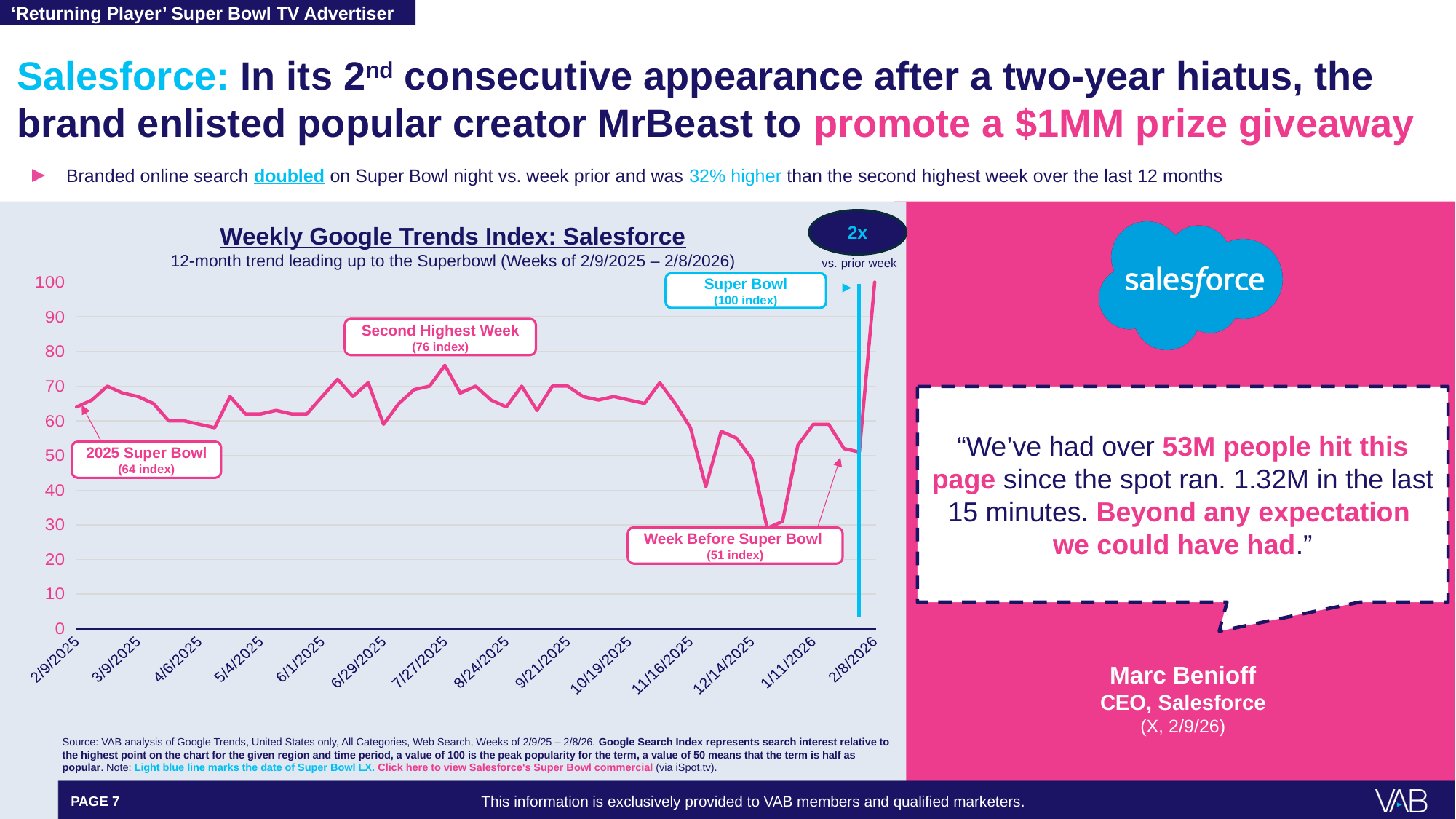
Is the lowest dip in the line, near 12/14/2025, greater or less than 40? less Which has a higher index: the 2025 Super Bowl week or the Week Before Super Bowl? 2025 Super Bowl week According to the callout above the chart, how much higher was the Super Bowl week index vs. the prior week? 2x What index value is labeled for the Week Before Super Bowl? 51 What is the index value for the Super Bowl week on the Weekly Google Trends Index chart? 100 What is the difference between the 2025 Super Bowl index and the Week Before Super Bowl index? 13 By how many index points does the Super Bowl week (100) exceed the Week Before Super Bowl (51)? 49 What kind of chart is shown on the slide? Line chart Which week has the highest value on the chart? Super Bowl week (2/8/2026) What is the difference between the Super Bowl week index and the Second Highest Week index? 24 What index value is labeled for the Second Highest Week? 76 What index value is labeled for the 2025 Super Bowl week? 64